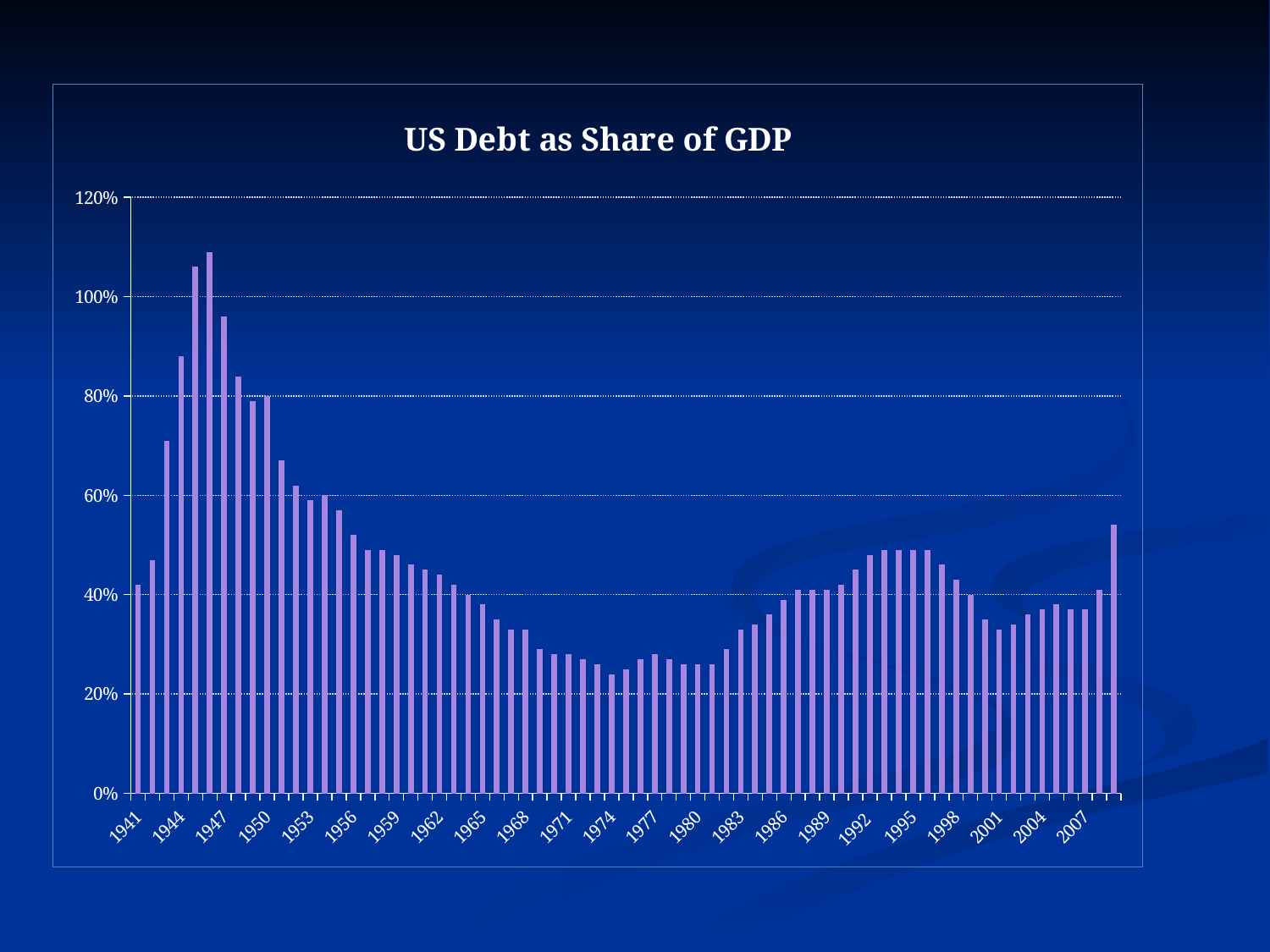
Is the value for 1974 greater or less than 20%? greater What kind of chart is shown on the slide? bar chart Is the value for 1968 greater or less than 40%? less Is the value for 2001 greater or less than 40%? less Do the values rise or fall between 1947 and 1974? fall What is the title of the chart? US Debt as Share of GDP Which year has the larger value, 1944 or 1947? 1947 Which year has the larger value, 1971 or 1992? 1992 What is the highest value shown on the vertical axis of the chart? 120%